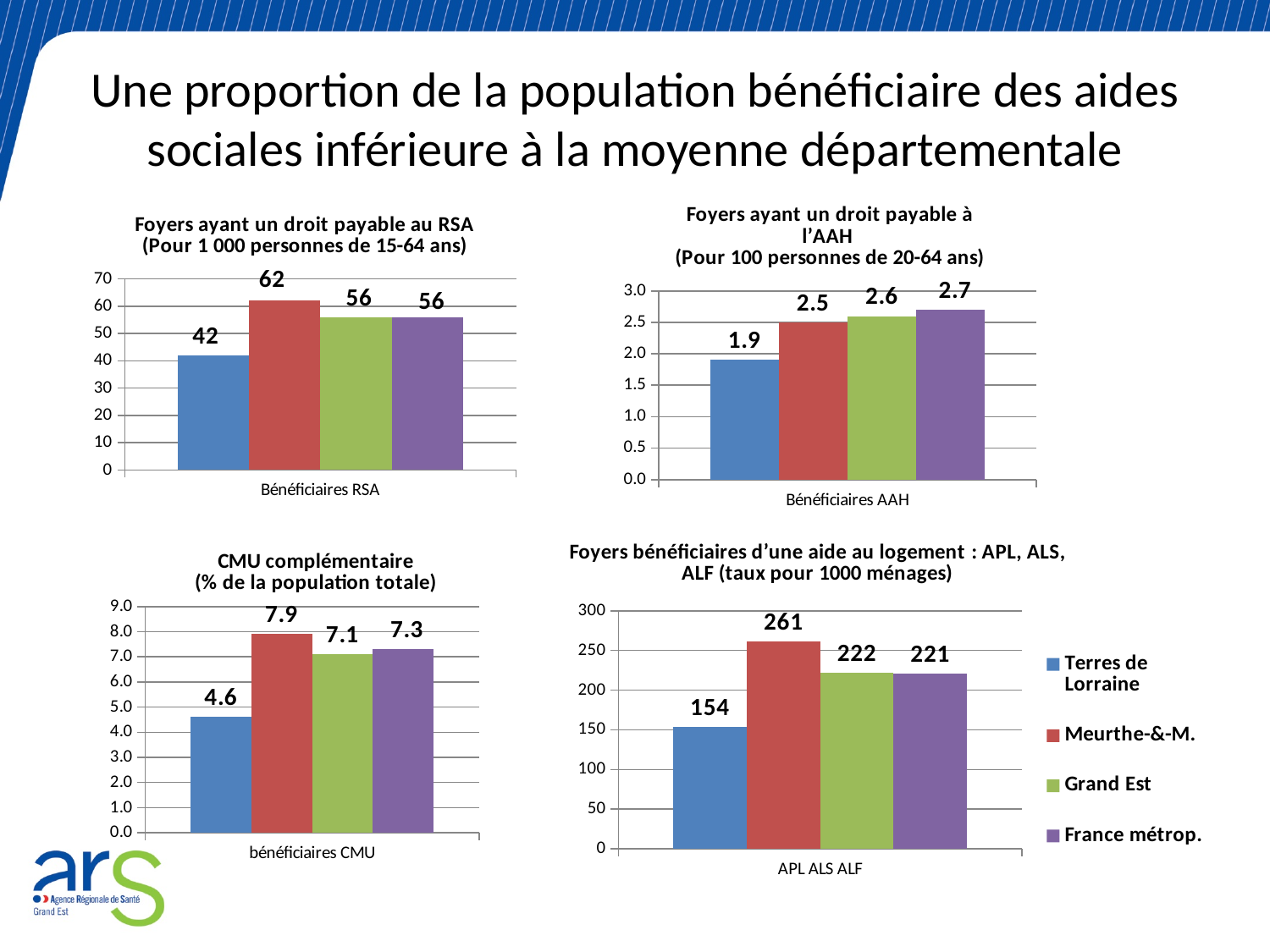
How many series does the legend of the chart titled 'Foyers bénéficiaires d'une aide au logement' list? 4 What type of chart is the chart titled 'CMU complémentaire'? Bar chart In the chart titled 'Foyers bénéficiaires d'une aide au logement', what is the category label on the x axis? APL ALS ALF In the chart titled 'CMU complémentaire', what is the value for Meurthe-&-M.? 7.9 In the chart titled 'Foyers bénéficiaires d'une aide au logement', what is the value for Terres de Lorraine? 154 In the chart titled 'Foyers bénéficiaires d'une aide au logement', what is the difference between the Meurthe-&-M. value and the Grand Est value? 39 In the chart titled 'Foyers ayant un droit payable à l'AAH', which series has the lowest value? Terres de Lorraine In the chart titled 'Foyers ayant un droit payable au RSA', which series has the highest value? Meurthe-&-M. In the chart titled 'Foyers ayant un droit payable au RSA', what is the difference between the Meurthe-&-M. value and the Terres de Lorraine value? 20 In the chart titled 'Foyers ayant un droit payable à l'AAH', what is the value for France métrop.? 2.7 In the chart titled 'Foyers ayant un droit payable au RSA', what is the value of the blue bar (Terres de Lorraine)? 42 In the chart titled 'CMU complémentaire', which is larger: the Grand Est value or the France métrop. value? France métrop.